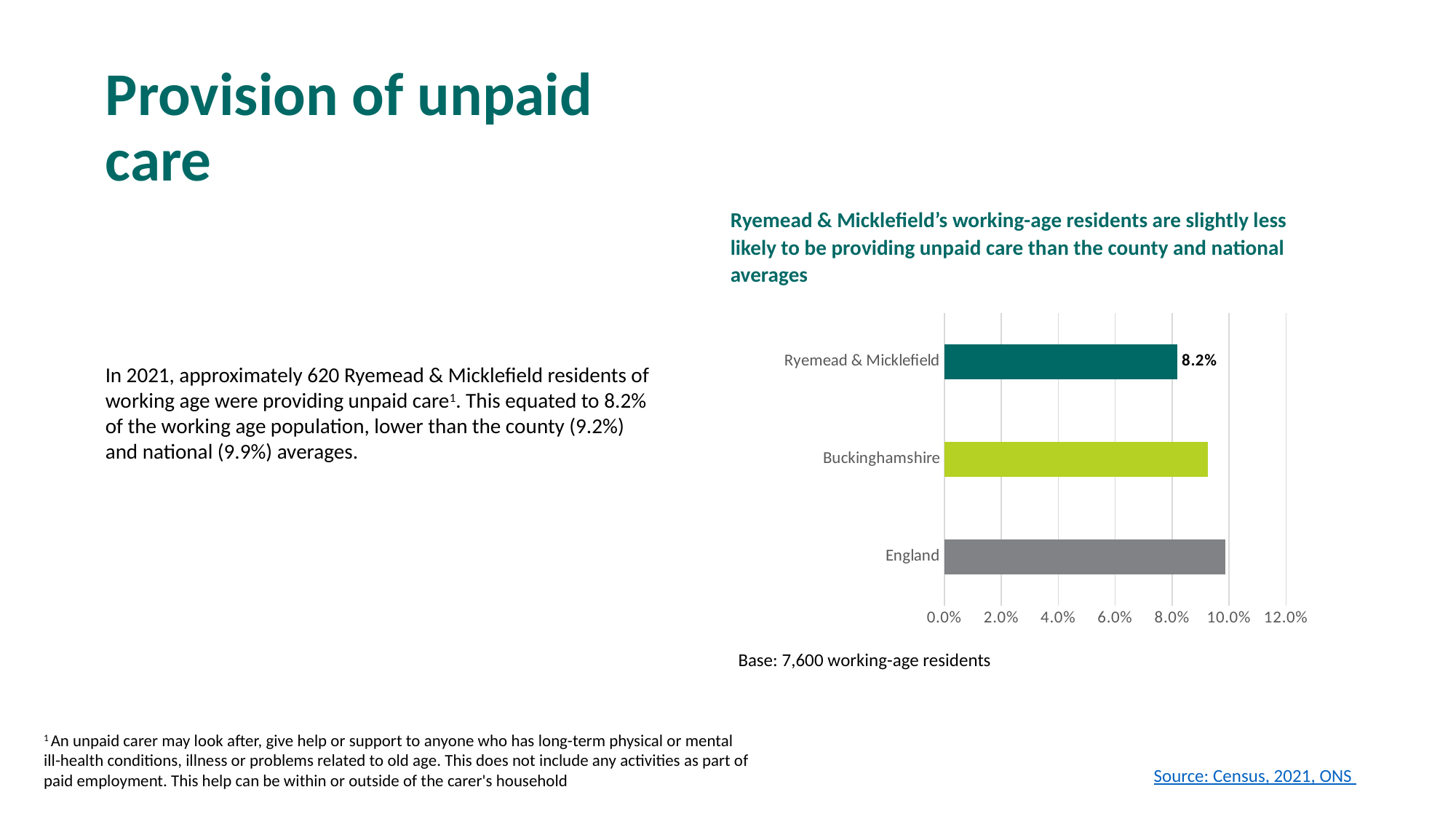
Is the value for England greater or less than 8.0%? greater What base is stated beneath the chart? 7,600 working-age residents Is the value for Buckinghamshire greater or less than 8.0%? greater What kind of chart is shown on the slide? Bar chart What is the highest value shown on the chart's x axis? 12.0% Which category has the highest value in the chart? England How many categories are plotted in the chart? 3 What is the value shown for Ryemead & Micklefield in the chart? 8.2% Is the value for Ryemead & Micklefield greater or less than 10.0%? less Which category has the lowest value in the chart? Ryemead & Micklefield Which has a larger value, Buckinghamshire or Ryemead & Micklefield? Buckinghamshire Which has a larger value, England or Buckinghamshire? England